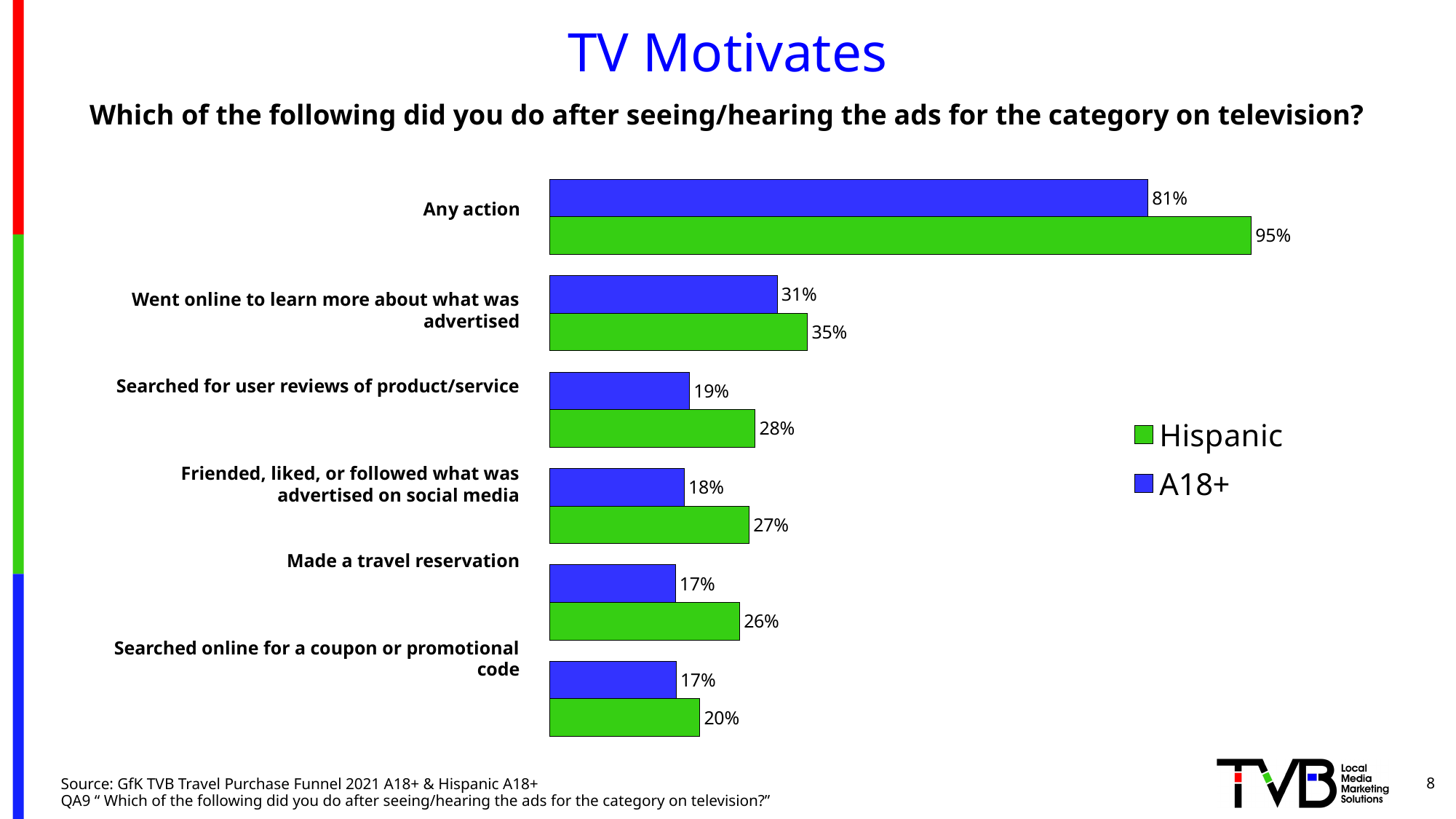
What is the A18+ value for "Made a travel reservation"? 17% What is the Hispanic value for "Any action"? 95% Which category has the highest Hispanic value? Any action Which category has the lowest Hispanic value? Searched online for a coupon or promotional code What is the difference between the Hispanic and A18+ values for "Searched for user reviews of product/service"? 9 percentage points How many series does the legend list? 2 For "Friended, liked, or followed what was advertised on social media", which is larger: the Hispanic value or the A18+ value? Hispanic What is the Hispanic value for "Searched for user reviews of product/service"? 28% How many categories are shown in the chart? 6 What kind of chart is shown on the slide? Bar chart What is the difference between the Hispanic and A18+ values for "Any action"? 14 percentage points What is the A18+ value for "Went online to learn more about what was advertised"? 31%